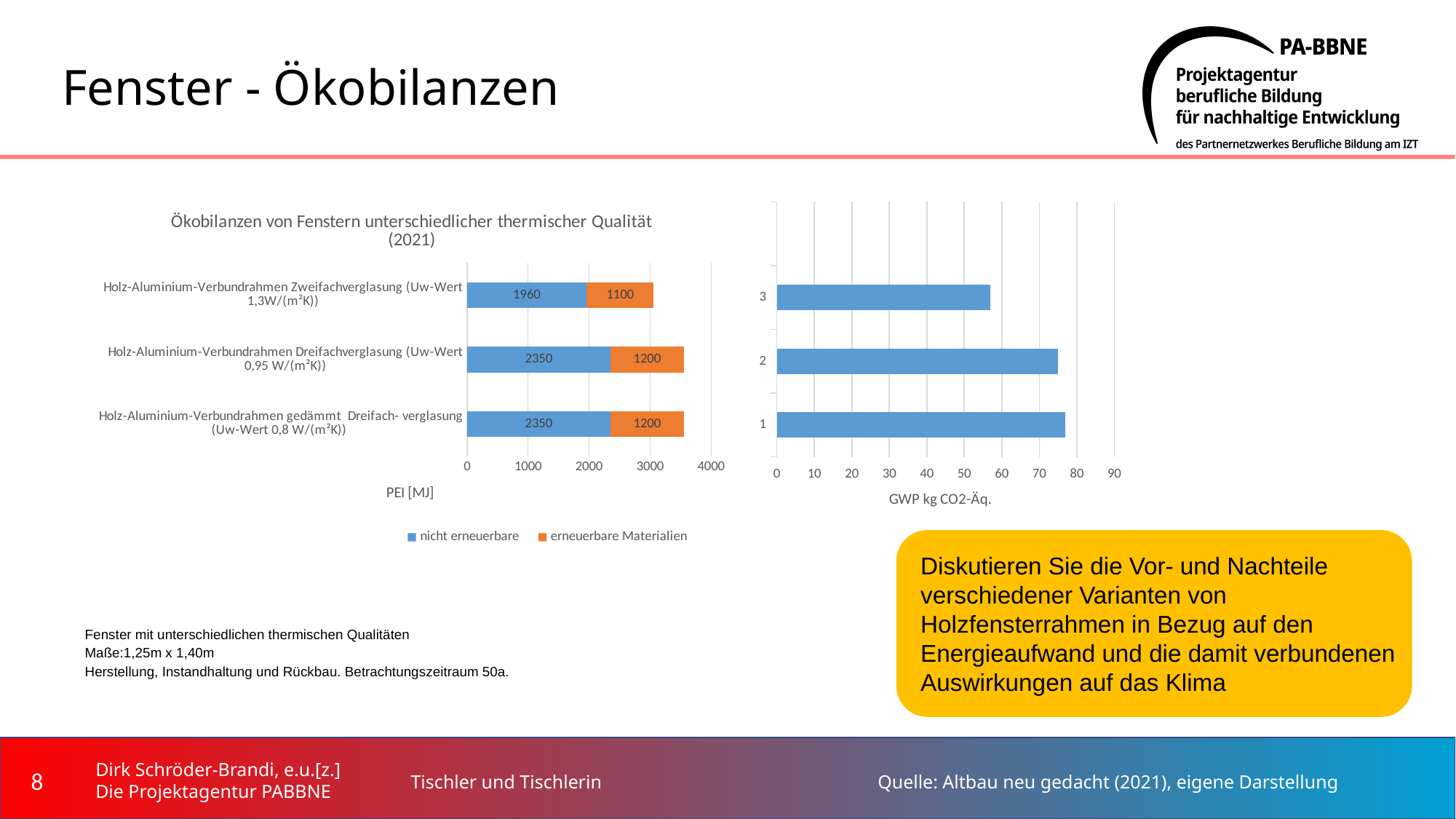
In the left chart titled 'Ökobilanzen von Fenstern unterschiedlicher thermischer Qualität (2021)', which category has the lowest 'nicht erneuerbare' value? Holz-Aluminium-Verbundrahmen Zweifachverglasung (Uw-Wert 1,3W/(m²K)) In the left chart titled 'Ökobilanzen von Fenstern unterschiedlicher thermischer Qualität (2021)', what is the 'nicht erneuerbare' value for Holz-Aluminium-Verbundrahmen Zweifachverglasung (Uw-Wert 1,3W/(m²K))? 1960 What kind of chart is the left chart titled 'Ökobilanzen von Fenstern unterschiedlicher thermischer Qualität (2021)'? Stacked bar chart In the left chart titled 'Ökobilanzen von Fenstern unterschiedlicher thermischer Qualität (2021)', what is the total PEI for Holz-Aluminium-Verbundrahmen gedämmt Dreifach-verglasung (Uw-Wert 0,8 W/(m²K))? 3550 In the left chart titled 'Ökobilanzen von Fenstern unterschiedlicher thermischer Qualität (2021)', what is the 'erneuerbare Materialien' value for Holz-Aluminium-Verbundrahmen Dreifachverglasung (Uw-Wert 0,95 W/(m²K))? 1200 In the right chart with the axis 'GWP kg CO2-Äq.', is the value for category 3 greater or less than 60? less In the left chart titled 'Ökobilanzen von Fenstern unterschiedlicher thermischer Qualität (2021)', what is the label of the horizontal axis? PEI [MJ] In the left chart titled 'Ökobilanzen von Fenstern unterschiedlicher thermischer Qualität (2021)', what is the difference between the 'nicht erneuerbare' values for Dreifachverglasung (Uw-Wert 0,95 W/(m²K)) and Zweifachverglasung (Uw-Wert 1,3W/(m²K))? 390 In the right chart with the axis 'GWP kg CO2-Äq.', is the value for category 1 greater or less than 70? greater In the left chart titled 'Ökobilanzen von Fenstern unterschiedlicher thermischer Qualität (2021)', what is the total PEI for Holz-Aluminium-Verbundrahmen Zweifachverglasung (Uw-Wert 1,3W/(m²K))? 3060 How many series does the legend of the left chart titled 'Ökobilanzen von Fenstern unterschiedlicher thermischer Qualität (2021)' list? 2 In the right chart with the axis 'GWP kg CO2-Äq.', which category has the lowest value? 3